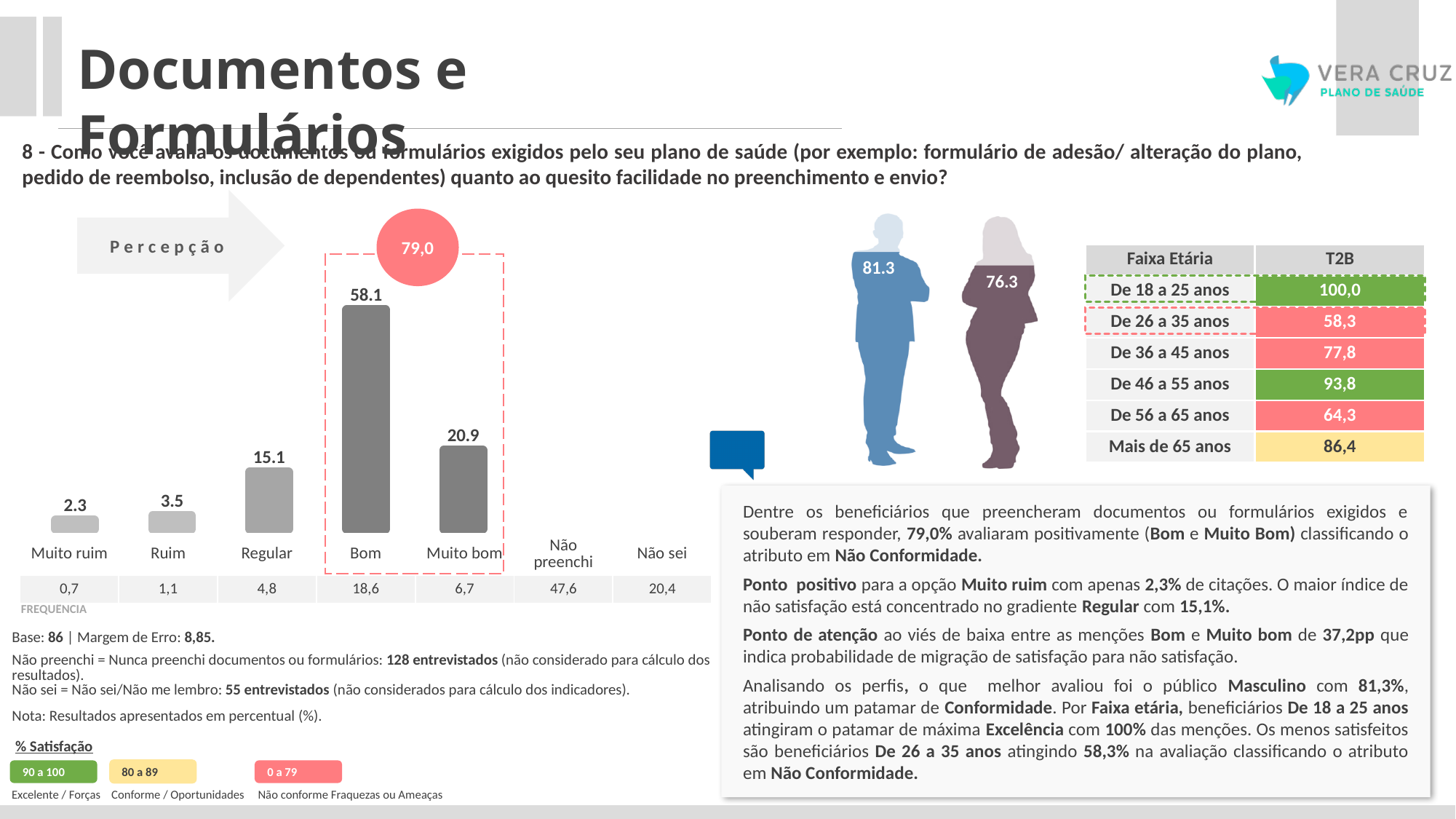
What value is shown in the red circle above the Bom and Muito bom bars? 79,0 In the Faixa Etária table, which age group has the lowest T2B value? De 26 a 35 anos In the bar chart, what is the value for Regular? 15.1 In the Faixa Etária table, what is the T2B value for De 46 a 55 anos? 93,8 In the bar chart, which category has the highest value? Bom In the bar chart, what is the difference between the values for Bom and Muito bom? 37.2 How many bars are plotted in the bar chart? 5 What value is shown on the male (blue) figure? 81.3 In the bar chart, which is larger: the value for Regular or the value for Muito bom? Muito bom In the bar chart, what is the value for Ruim? 3.5 What type of chart is used to show the evaluation categories (Muito ruim to Muito bom)? bar chart In the bar chart, which category has the lowest value? Muito ruim